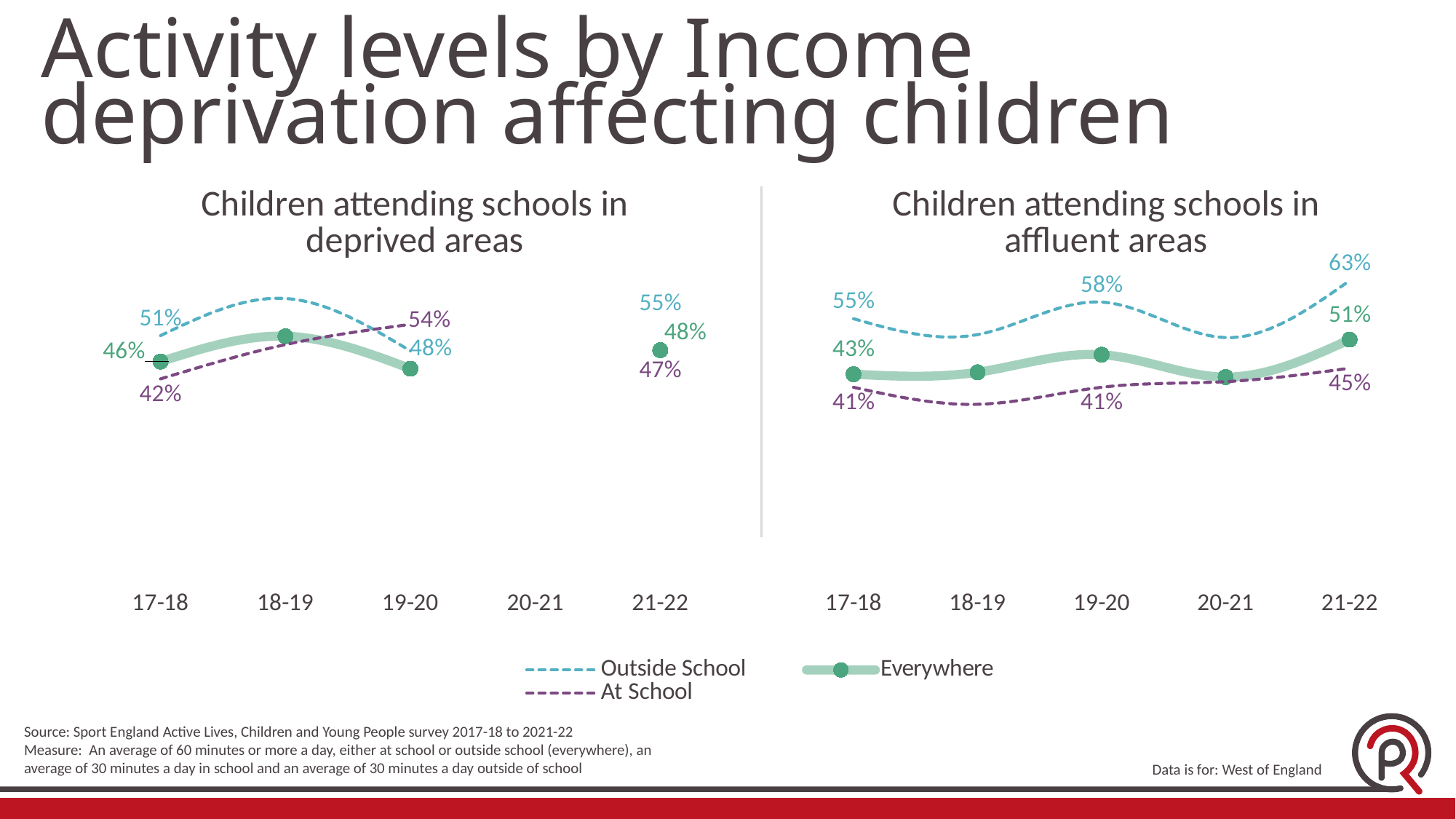
In the 'Children attending schools in deprived areas' chart, what is the Outside School value for 17-18? 51% In the 'Children attending schools in affluent areas' chart, what is the Everywhere value for 17-18? 43% In the 'Children attending schools in deprived areas' chart, which is higher in 21-22: Outside School or At School? Outside School How many series does the legend list? 3 In the 'Children attending schools in affluent areas' chart, by how many percentage points did the Outside School value change from 17-18 to 21-22? 8 percentage points In the 'Children attending schools in deprived areas' chart, what is the At School value for 19-20? 54% In the 'Children attending schools in affluent areas' chart, which year has the highest Outside School value? 21-22 How many year categories are shown on the x axis of the 'Children attending schools in affluent areas' chart? 5 In the 'Children attending schools in deprived areas' chart, what is the Everywhere value for 21-22? 48% What kind of chart is used for 'Children attending schools in deprived areas'? line chart In the 'Children attending schools in affluent areas' chart, what is the Outside School value for 21-22? 63% In the 'Children attending schools in affluent areas' chart, does the Outside School value rise or fall from 17-18 to 21-22? rise